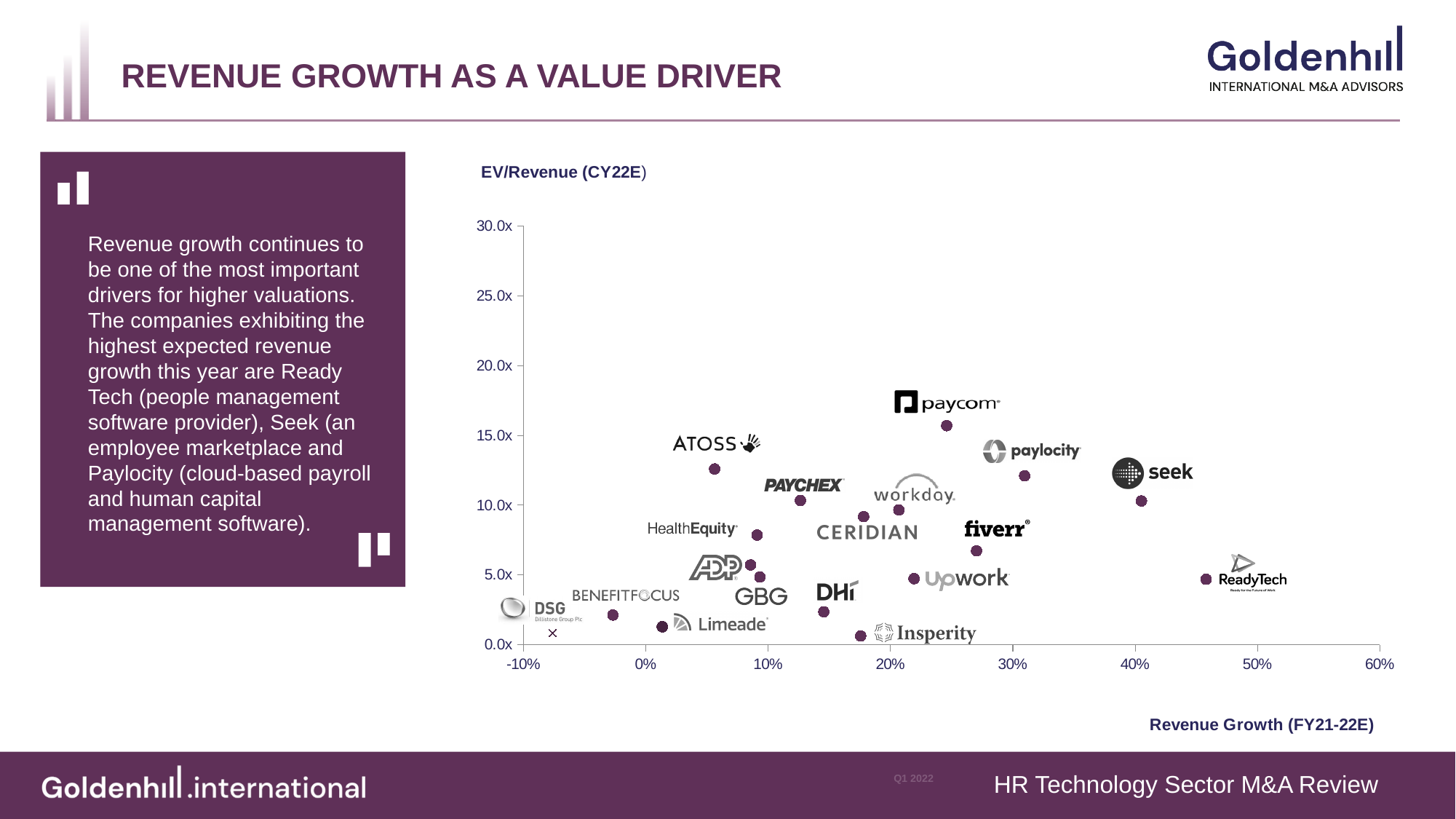
What is the label of the vertical axis of the chart? EV/Revenue (CY22E) Is the revenue growth for ReadyTech greater or less than 40%? greater What kind of chart is shown on the slide? Scatter chart Which company has the highest EV/Revenue multiple on the chart? Paycom Which company has the highest revenue growth on the chart? ReadyTech Is the EV/Revenue multiple for Insperity greater or less than 5.0x? less Which has a higher EV/Revenue multiple, Paycom or Seek? Paycom What is the label of the horizontal axis of the chart? Revenue Growth (FY21-22E) Which has higher revenue growth, Seek or Paylocity? Seek Is the revenue growth for Benefitfocus greater or less than 0%? less Which company has the lowest revenue growth on the chart? DSG